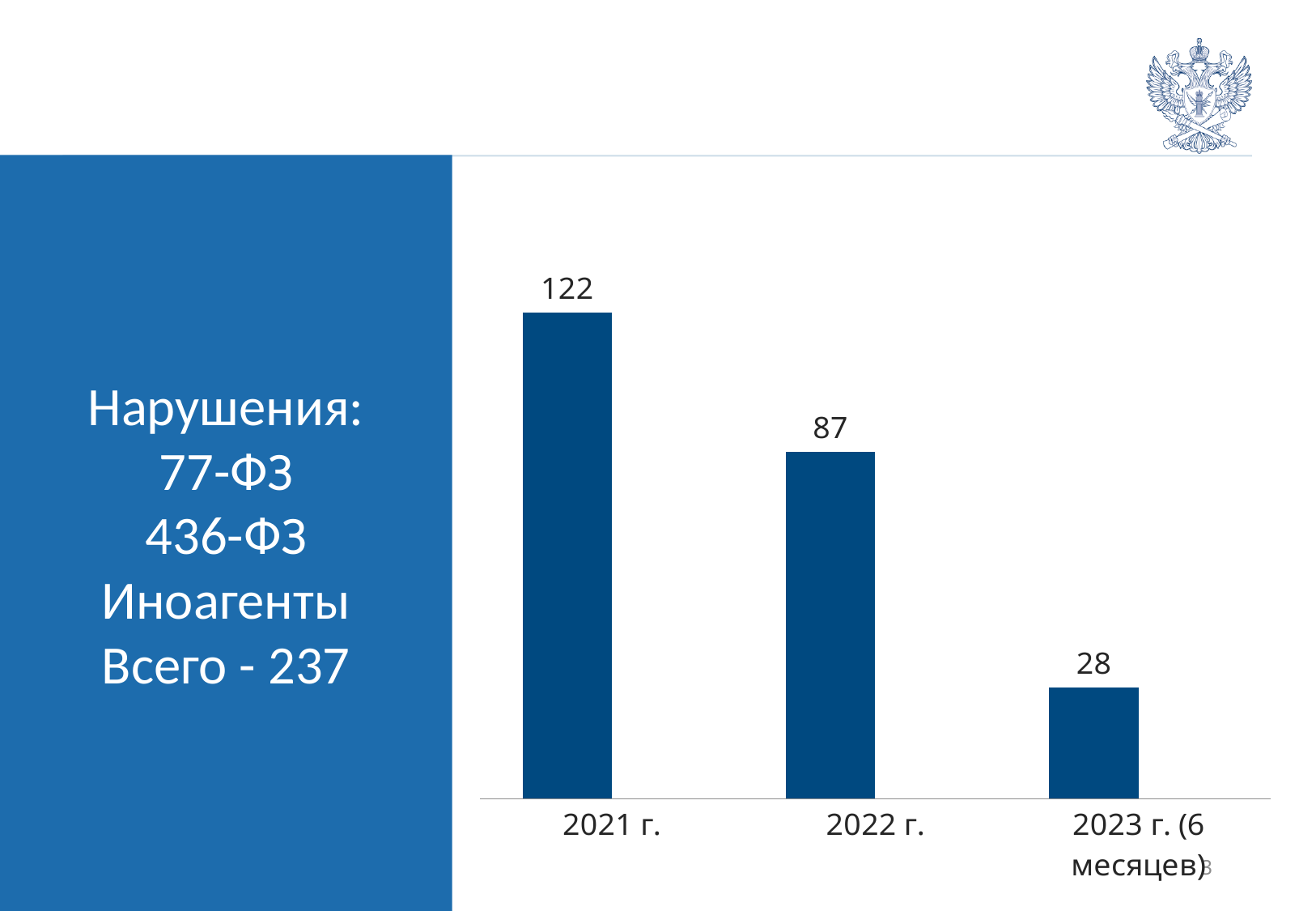
What is the value for 2021 г.? 122 What total number of violations is stated in the text panel on the left of the slide? 237 Which category has the lowest value? 2023 г. (6 месяцев) What is the value for 2022 г.? 87 What is the difference between the values for 2021 г. and 2022 г.? 35 Which is larger, the value for 2021 г. or the value for 2022 г.? 2021 г. Do the values rise or fall from 2021 г. to 2023 г. (6 месяцев)? fall What kind of chart is shown on the slide? bar chart What is the value for 2023 г. (6 месяцев)? 28 Which category has the highest value? 2021 г. How many categories are shown on the chart? 3 What is the difference between the values for 2022 г. and 2023 г. (6 месяцев)? 59